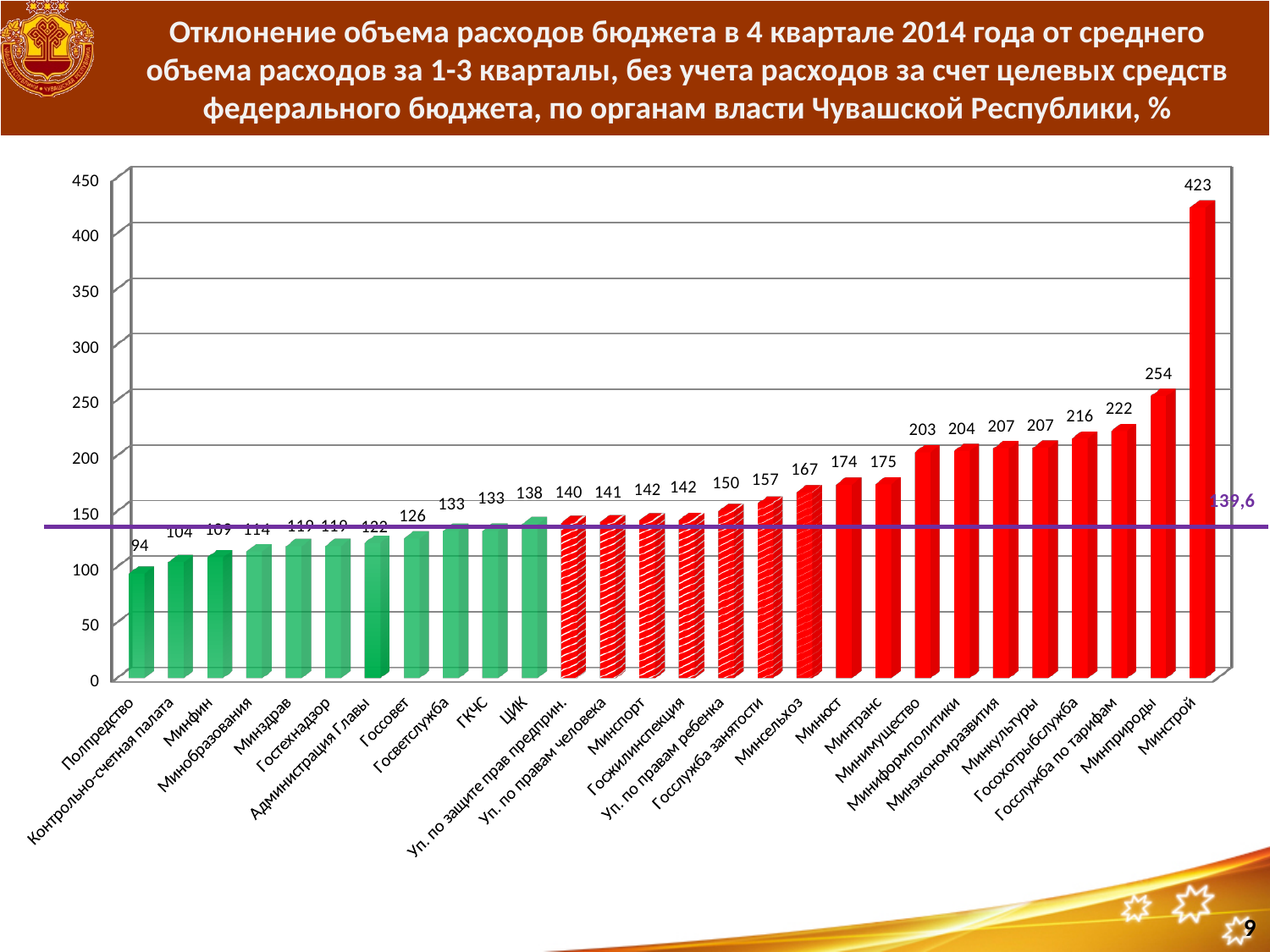
Which is larger, the value for Минимущество or the value for Госслужба занятости? Минимущество Which category has the lowest value? Полпредство What is the value for Минприроды? 254 What is the value for Минсельхоз? 167 How many categories are shown on the x axis? 28 What is the value for Полпредство? 94 What is the difference between the values for Минстрой and Минприроды? 169 What is the difference between the values for Госслужба по тарифам and Госохотрыбслужба? 6 Is the value for Минстрой greater or less than 400? greater Which category has the highest value? Минстрой What is the value for Минстрой? 423 What value is marked by the horizontal purple line across the chart? 139,6